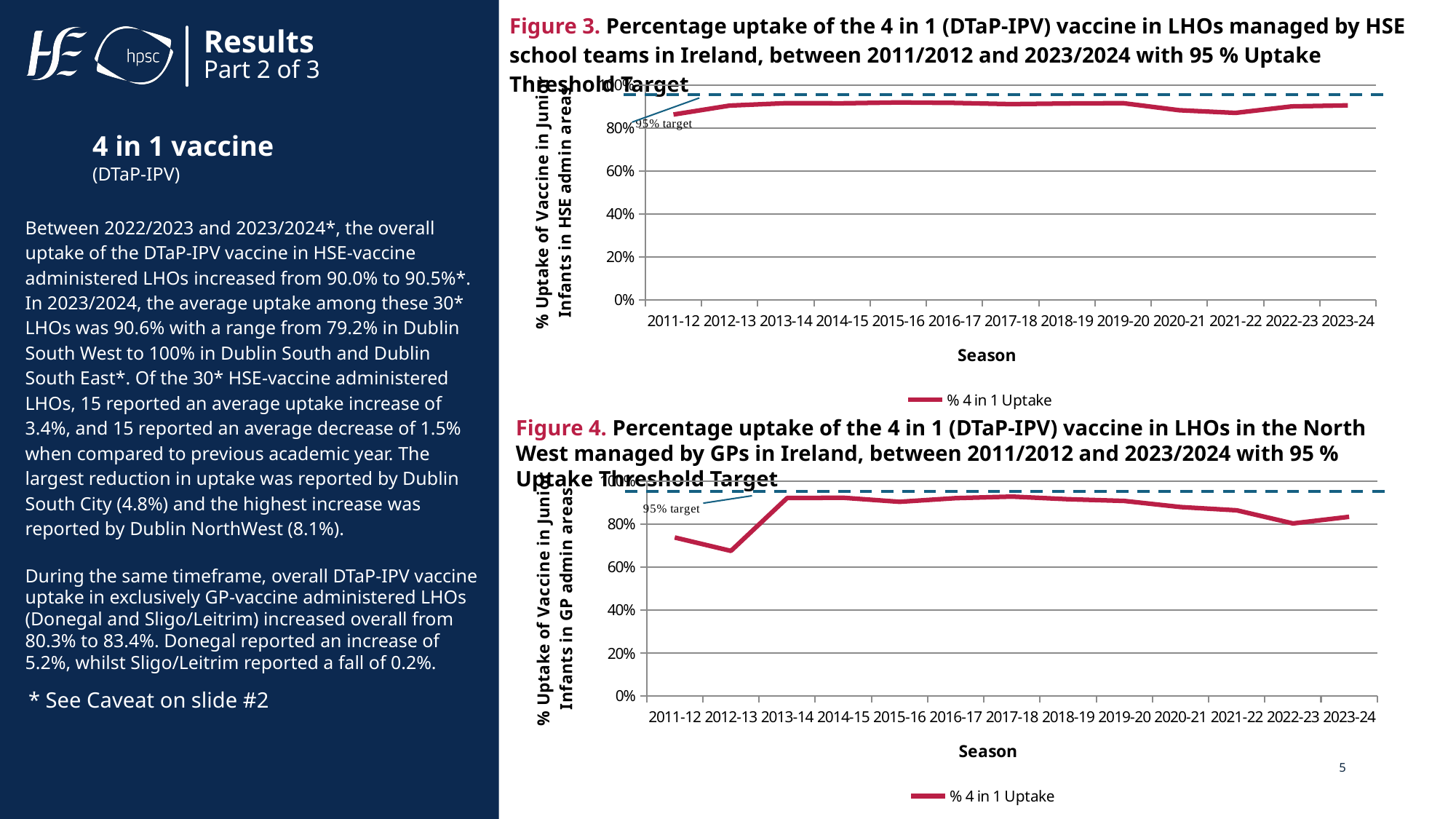
In Figure 4, is the value for 2012-13 greater or less than 80%? less What kind of chart is Figure 3? Line chart In Figure 4, is the value for 2013-14 greater or less than 80%? greater In Figure 4, does the uptake rise or fall between 2012-13 and 2013-14? rise In Figure 3, how many series does the legend list? 1 In Figure 3, is the value for 2011-12 greater or less than 80%? greater In Figure 3, how many seasons are plotted along the x axis? 13 In Figure 4, which season has the lowest uptake? 2012-13 In Figure 4, what is the x-axis title? Season What kind of chart is Figure 4? Line chart In Figure 3, what does the dashed horizontal line represent? 95% target